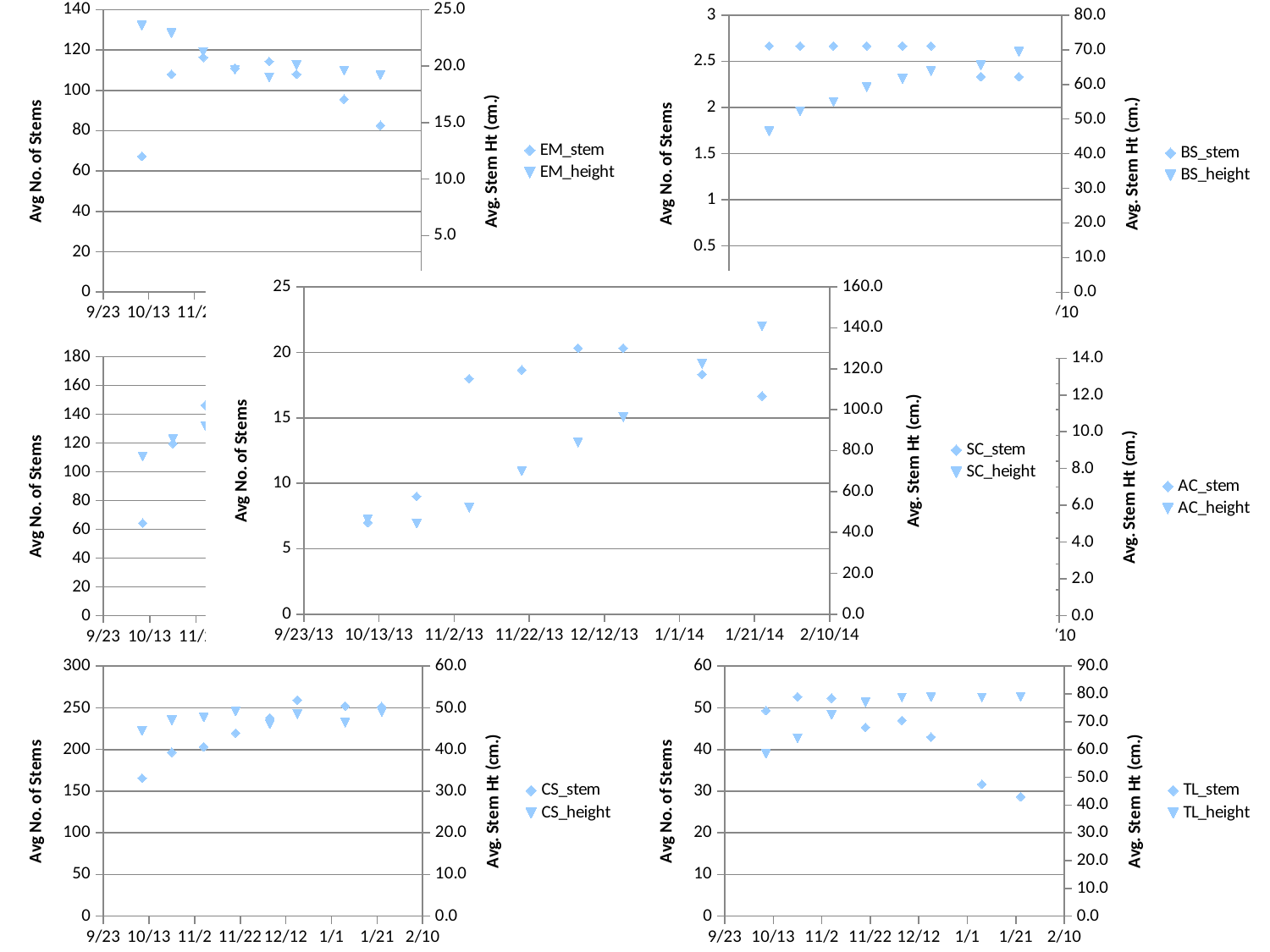
In the bottom-right chart (TL), do the TL_stem values rise or fall along the x axis? fall In the centre chart (SC), how many SC_stem points are plotted? 8 In the bottom-left chart (CS), is the first CS_stem value (around 10/13) greater or less than 150 on the left axis? greater In the centre chart (SC), is the first SC_stem value (around 10/13/13) greater or less than 10 on the left axis? less How many series does the legend of the top-left chart (EM) list? 2 In the top-left chart (EM), do the EM_height values generally rise or fall along the x axis? fall In the top-right chart (BS), is the first BS_height value greater or less than 50.0 on the right axis? less What kind of chart is the chart with the SC_stem and SC_height legend in the centre of the slide? scatter chart In the top-right chart (BS), do the BS_height values rise or fall along the x axis? rise